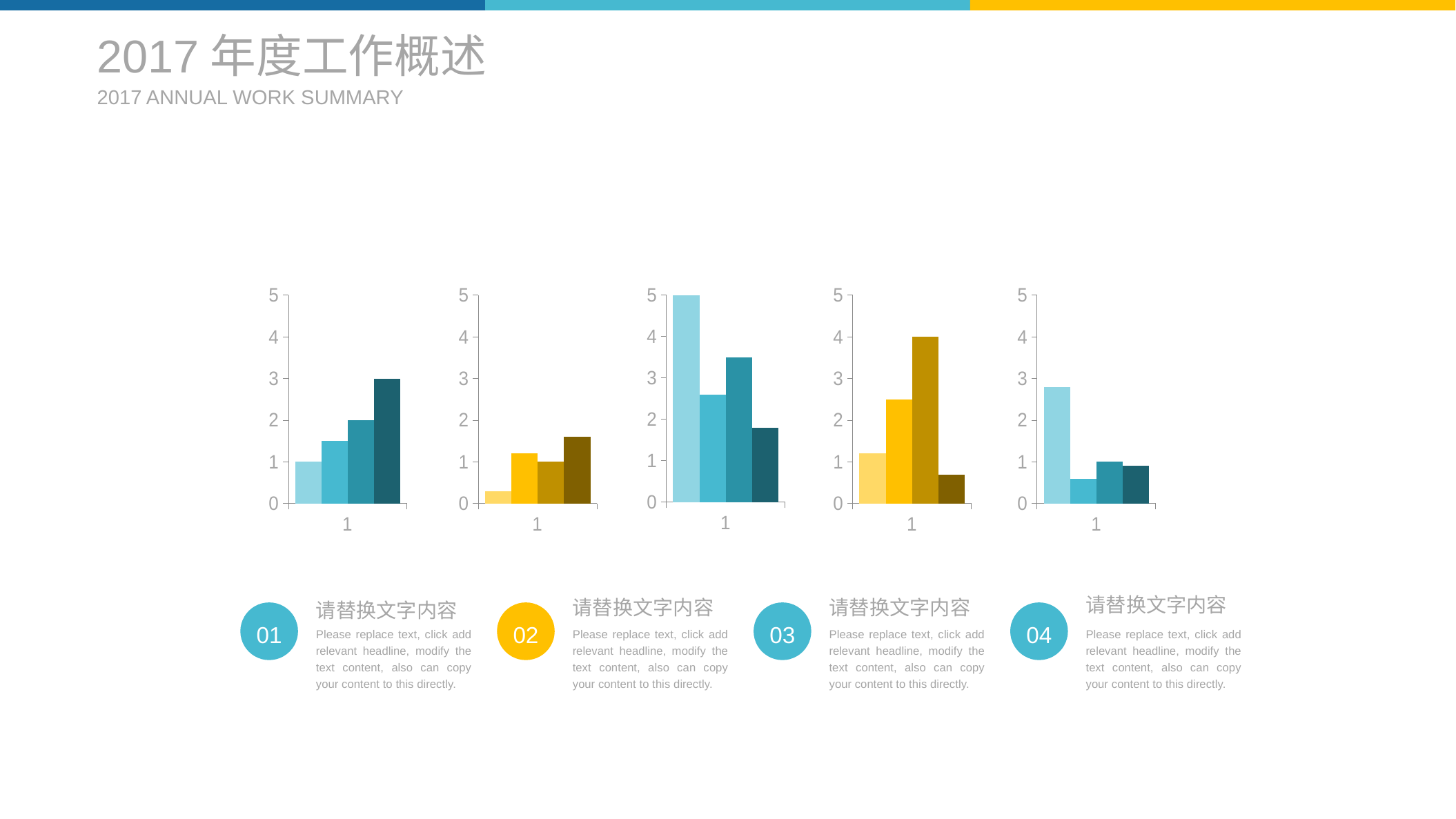
In the middle (third) chart, what is the value of the tallest bar? 5 In the middle (third) chart, which bar is the highest? the leftmost (light blue) bar In the rightmost chart, is the value of the leftmost (light blue) bar greater or less than 2? greater In the leftmost chart, do the bars rise or fall from left to right? rise In the fourth chart from the left, what is the value of the tallest bar? 4 In the leftmost chart, what is the difference between the tallest bar and the shortest bar? 2 How many bar charts are shown on the slide? 5 In the leftmost chart, what is the value of the tallest (darkest) bar? 3 What kind of chart is the leftmost chart on the slide? bar chart In the fourth chart from the left, which bar is the lowest? the rightmost (dark brown) bar How many bars does the leftmost chart show? 4 In the second chart from the left, is the value of the tallest bar greater or less than 2? less